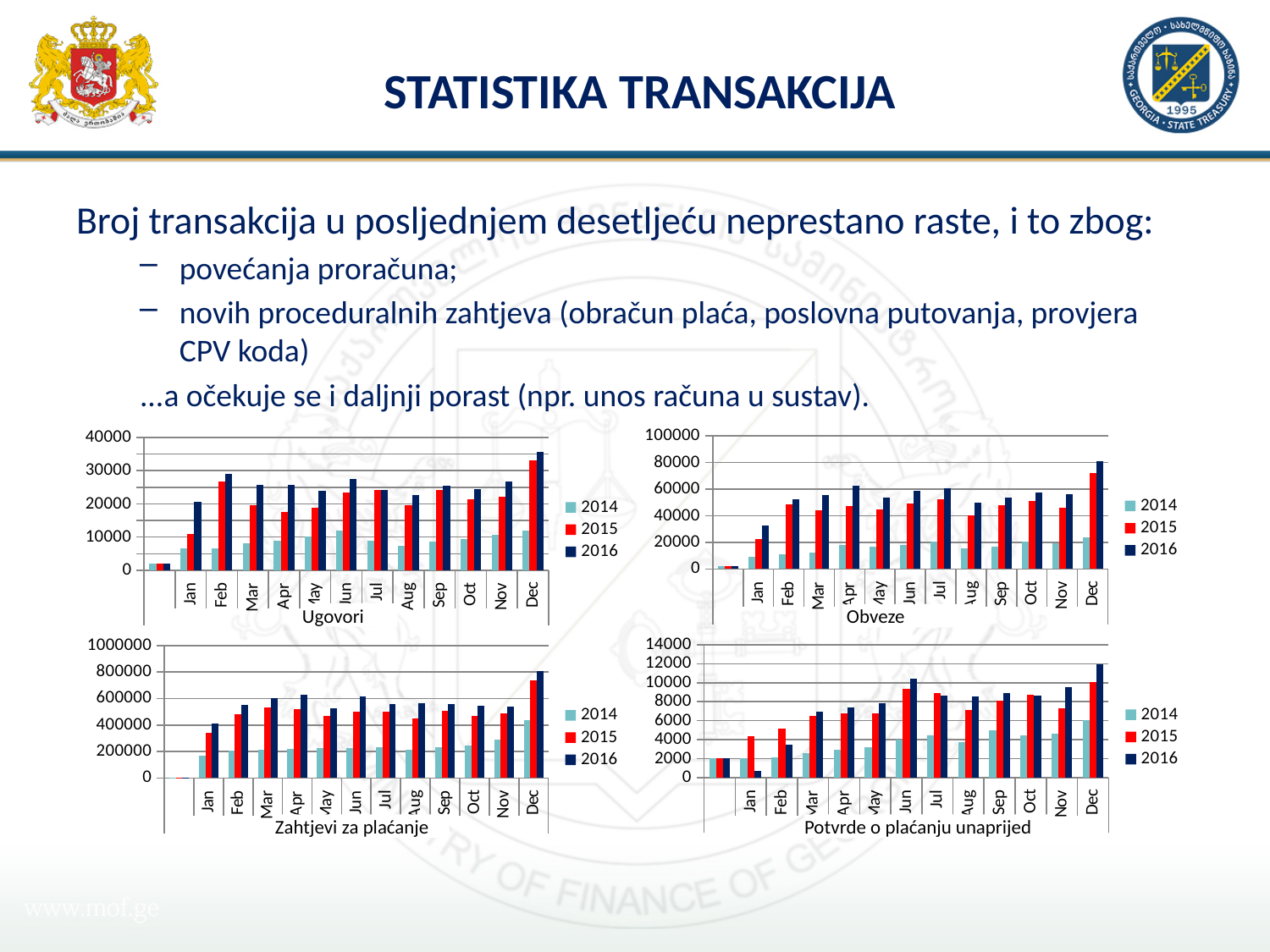
In the "Zahtjevi za plaćanje" chart, is the 2016 value for Dec greater or less than 600000? greater How many months are shown on the x axis of the "Zahtjevi za plaćanje" chart? 12 In the "Potvrde o plaćanju unaprijed" chart, which month has the highest 2016 value? Dec In the "Ugovori" chart, which month has the lowest 2015 value? Jan What kind of chart is the "Ugovori" chart? bar chart In the "Ugovori" chart, which is larger, the 2015 value for Feb or the 2015 value for Mar? Feb Which years are listed in the legend of the "Potvrde o plaćanju unaprijed" chart? 2014, 2015, 2016 How many series does the legend of the "Obveze" chart list? 3 In the "Ugovori" chart, is the 2016 value for Dec greater or less than 30000? greater In the "Obveze" chart, is the 2016 value for Dec greater or less than 60000? greater In the "Obveze" chart, which month has the highest 2016 value? Dec In the "Ugovori" chart, which month has the highest 2016 value? Dec